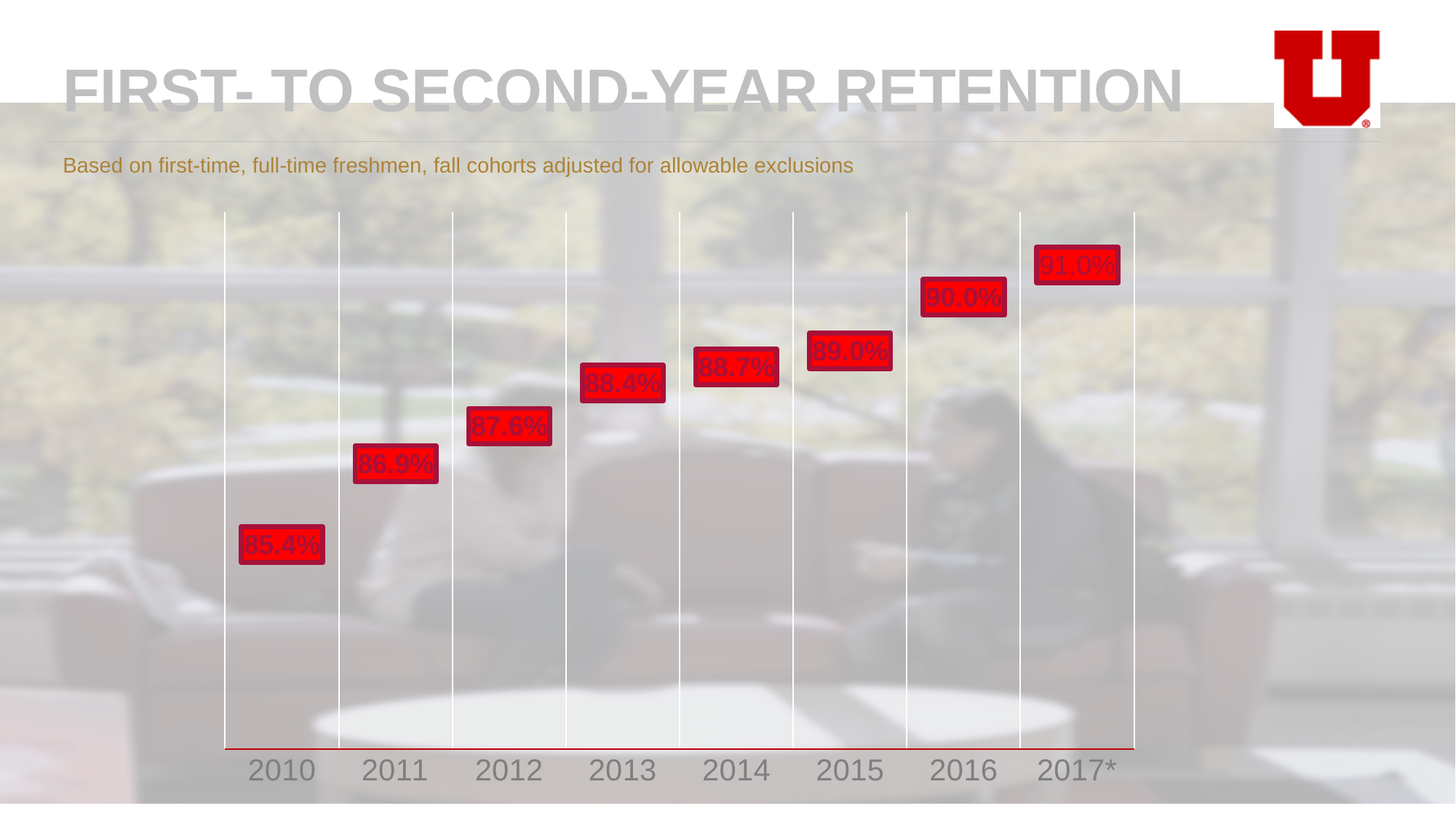
Which year has the highest retention rate? 2017* What is the retention rate shown for 2012? 87.6% What is the retention rate shown for 2014? 88.7% Do the retention rates rise or fall from 2010 to 2017*? rise What is the difference between the retention rates for 2016 and 2015? 1.0% Which year has a higher retention rate, 2013 or 2011? 2013 Which year has the lowest retention rate? 2010 What is the retention rate shown for 2017*? 91.0% What is the difference between the retention rates for 2017* and 2010? 5.6% How many years are shown on the x axis of the chart? 8 What is the first- to second-year retention rate for 2010? 85.4% What is the title of the slide containing the chart? FIRST- TO SECOND-YEAR RETENTION